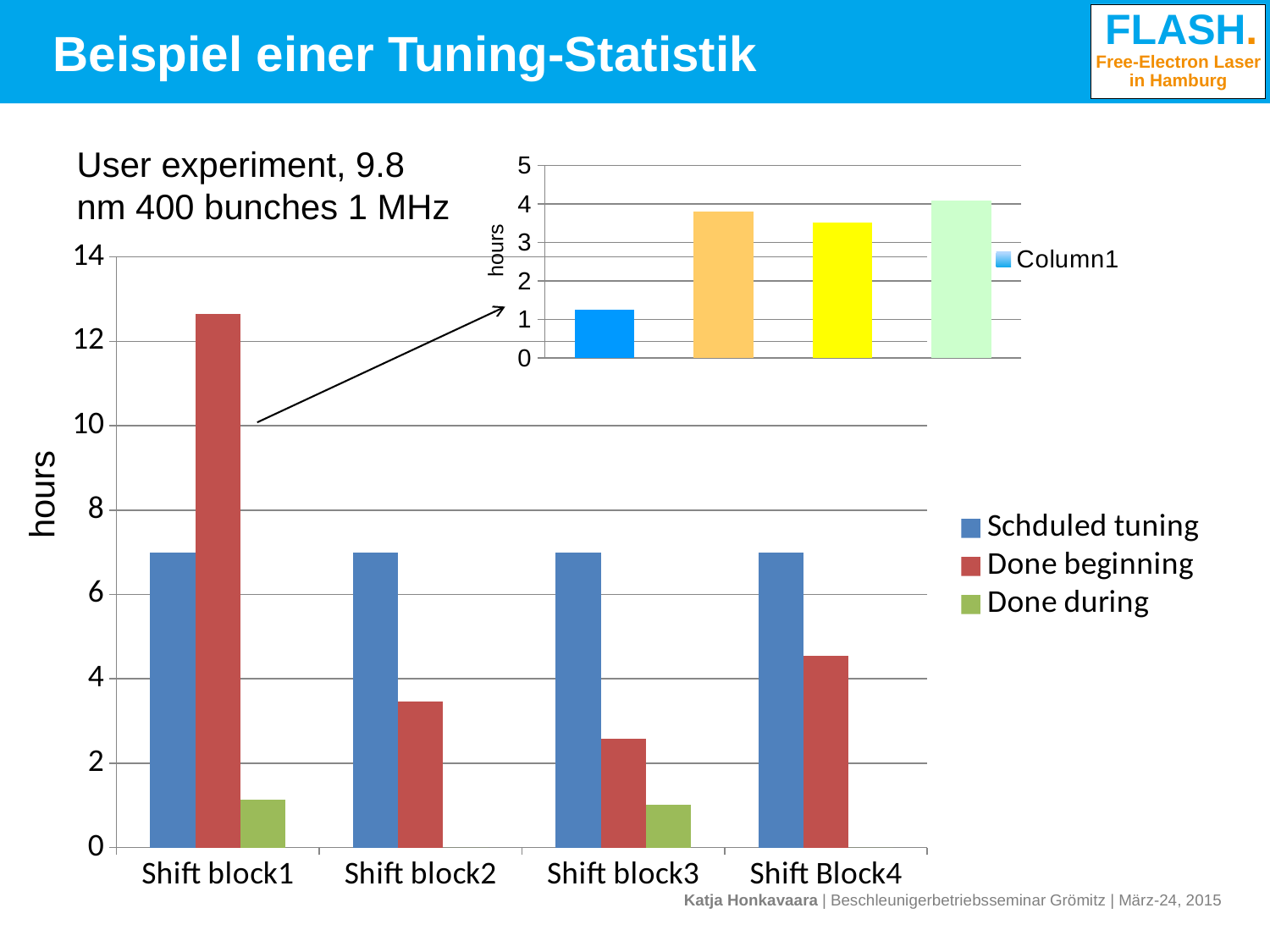
In the large chart on the left, which has the larger Done beginning value: Shift block2 or Shift Block4? Shift Block4 In the large chart on the left, which is larger for Shift block1: Schduled tuning or Done beginning? Done beginning In the large chart on the left, which shift block has the highest value for Done beginning? Shift block1 In the large chart on the left, is the Done beginning value for Shift block1 greater or less than 12? greater In the small inset chart at the top right, is the value of the first (leftmost) bar greater or less than 2? less What kind of chart is the large chart on the left of the slide? bar chart In the large chart on the left, what is the label of the y axis? hours In the small inset chart at the top right, how many bars are plotted? 4 In the large chart on the left, which shift block has the lowest value for Done beginning? Shift block3 In the large chart on the left, how many series does the legend list? 3 In the large chart on the left, how many shift blocks are shown on the x axis? 4 In the large chart on the left, is the Done beginning value for Shift block2 greater or less than 4? less